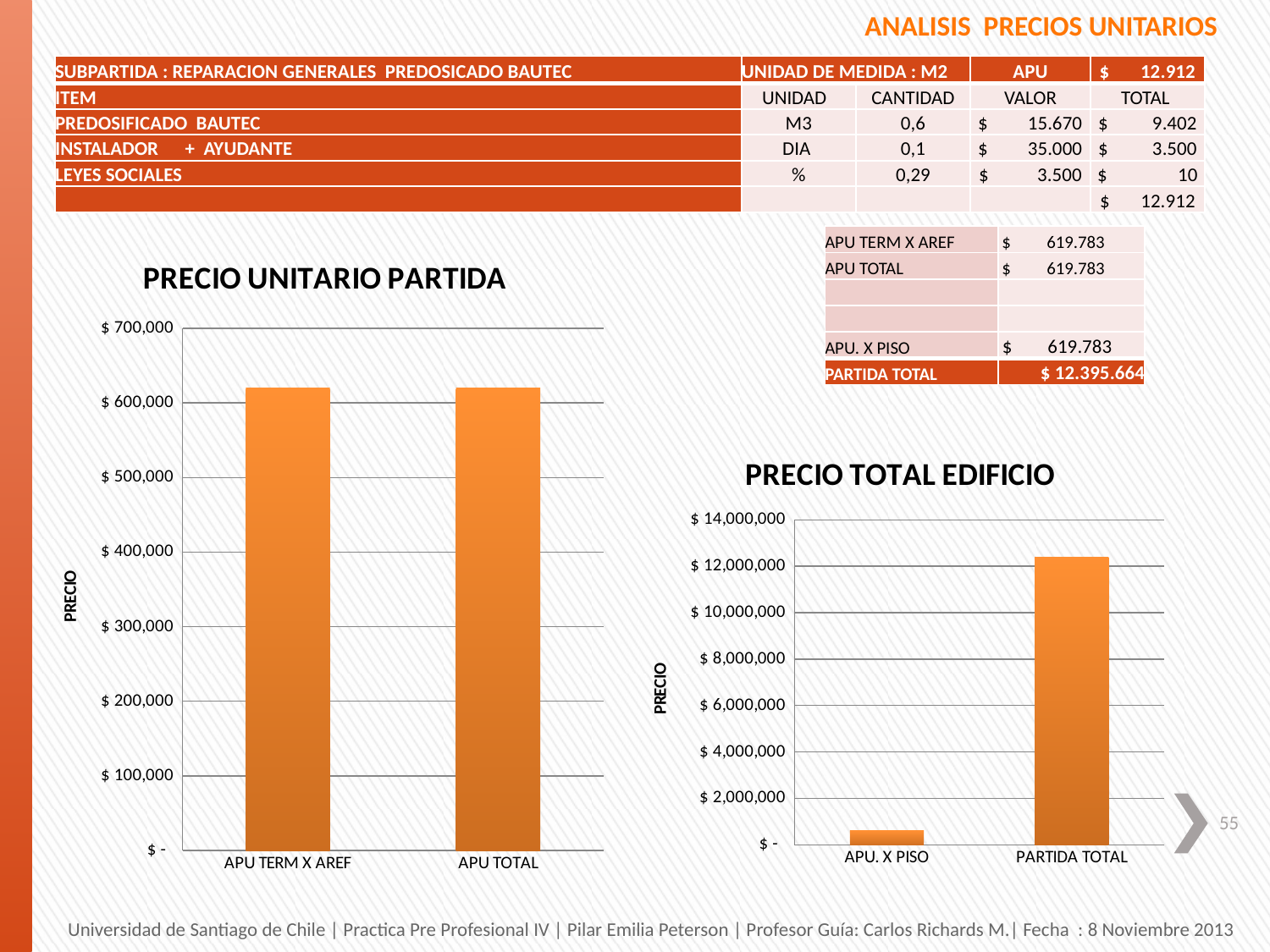
In the 'PRECIO TOTAL EDIFICIO' chart, is the value for APU. X PISO greater or less than $ 2,000,000? less In the 'PRECIO UNITARIO PARTIDA' chart, is the value for APU TERM X AREF greater or less than $ 500,000? greater What kind of chart is the 'PRECIO UNITARIO PARTIDA' chart? bar chart How many categories are shown in the 'PRECIO UNITARIO PARTIDA' chart? 2 In the 'PRECIO TOTAL EDIFICIO' chart, which category has the lowest value? APU. X PISO How many categories are shown in the 'PRECIO TOTAL EDIFICIO' chart? 2 What is the label on the vertical axis of the 'PRECIO TOTAL EDIFICIO' chart? PRECIO In the 'PRECIO TOTAL EDIFICIO' chart, is the value for PARTIDA TOTAL greater or less than $ 10,000,000? greater In the 'PRECIO TOTAL EDIFICIO' chart, which category has the highest value? PARTIDA TOTAL What kind of chart is the 'PRECIO TOTAL EDIFICIO' chart? bar chart In the 'PRECIO TOTAL EDIFICIO' chart, which is larger: APU. X PISO or PARTIDA TOTAL? PARTIDA TOTAL